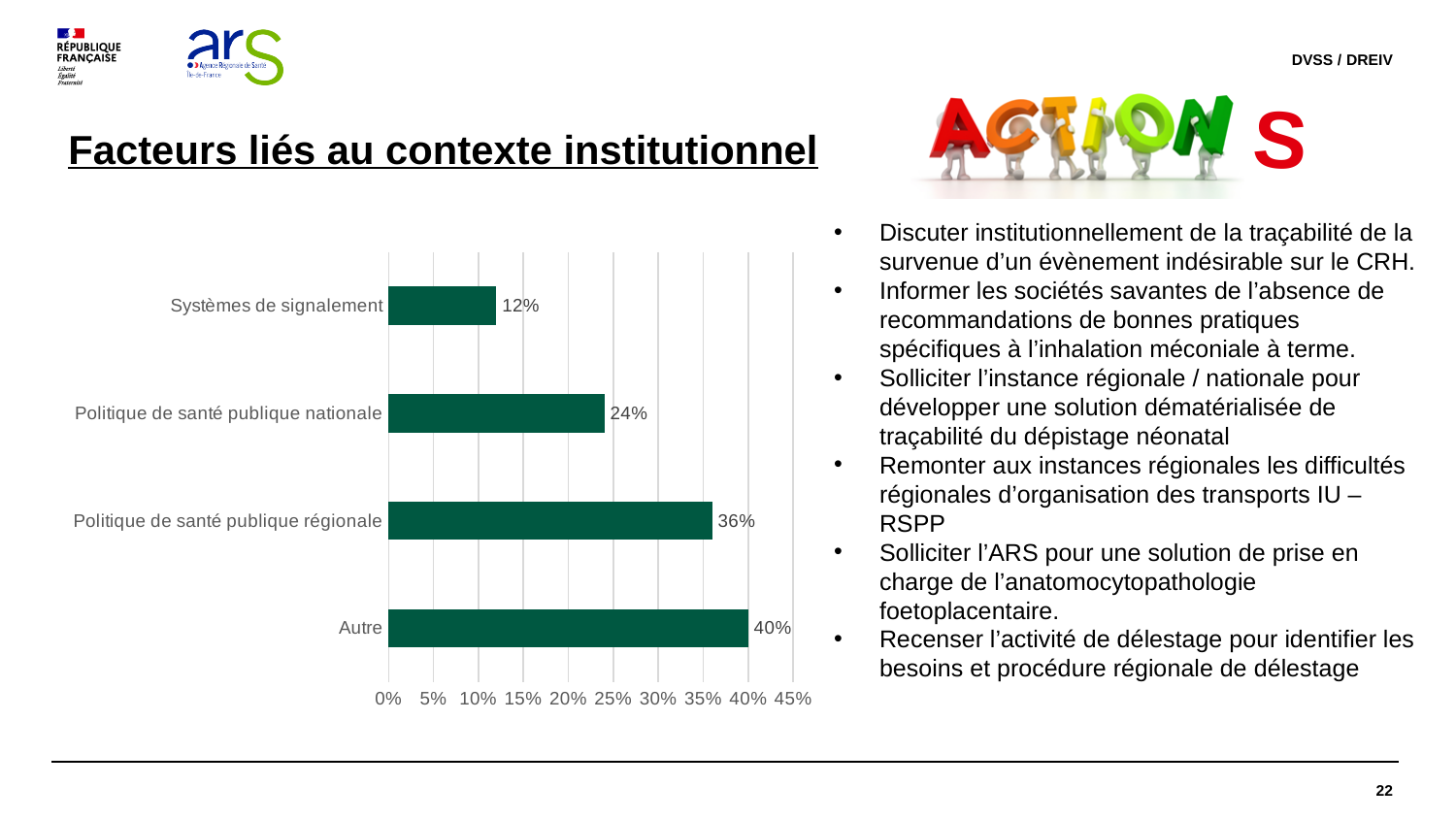
Which category has the highest value? Autre What is the value for Politique de santé publique nationale? 24% Which category has the lowest value? Systèmes de signalement What is the value for Autre? 40% What is the difference between the values for Politique de santé publique nationale and Systèmes de signalement? 12% What is the value for Politique de santé publique régionale? 36% Which is larger, the value for Politique de santé publique régionale or Politique de santé publique nationale? Politique de santé publique régionale What is the value for Systèmes de signalement? 12% What kind of chart is shown on the slide? Bar chart Is the value for Politique de santé publique régionale greater or less than 30%? greater What is the difference between the values for Autre and Politique de santé publique régionale? 4% How many categories are shown in the chart? 4